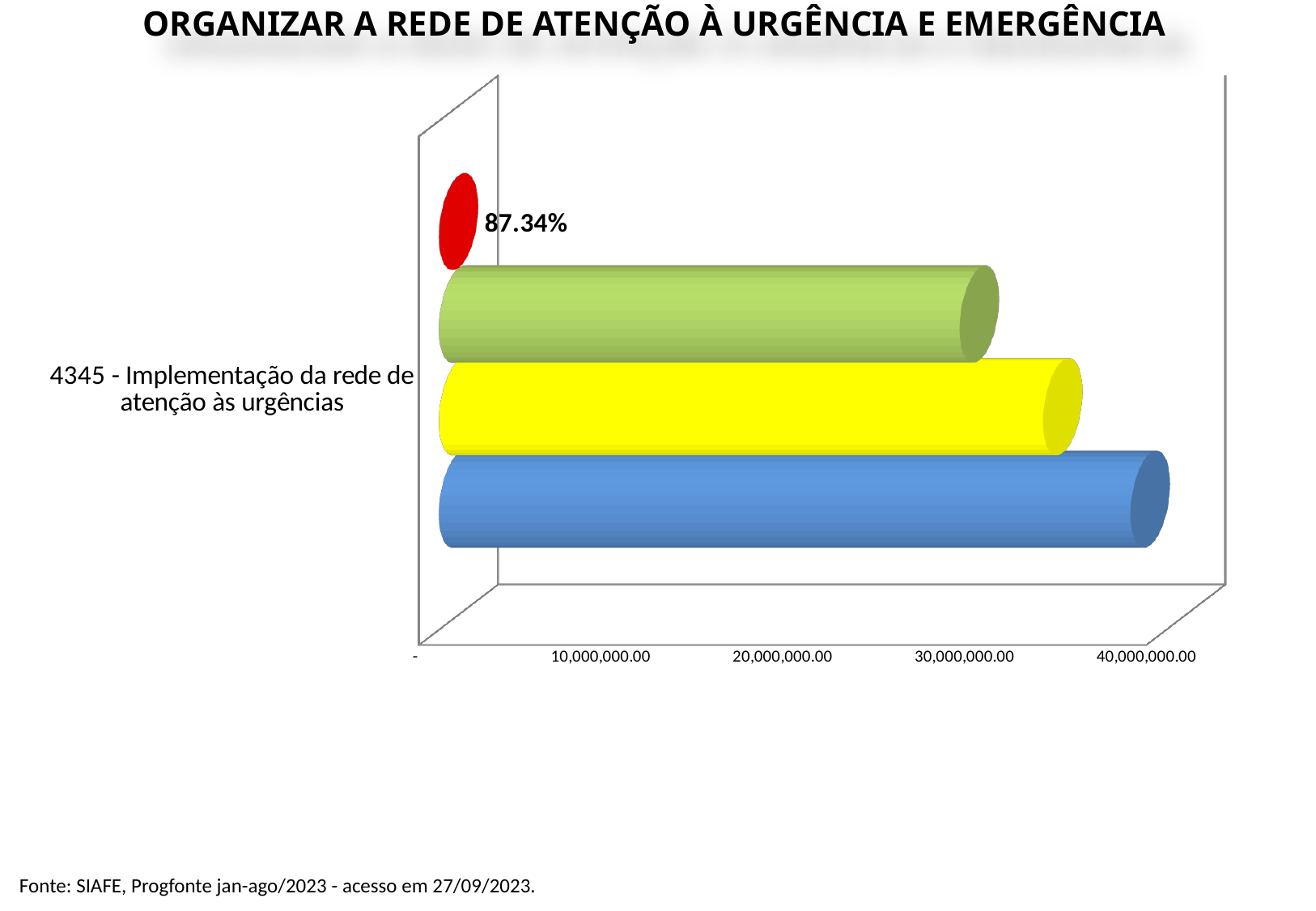
Is the value of the red bar greater or less than 10,000,000.00? less How many categories are shown on the vertical axis of the chart? 1 Is the value of the blue bar greater or less than 30,000,000.00? greater What kind of chart is shown on the slide? bar chart Which coloured bar is the shortest in the chart? red Is the value of the yellow bar greater or less than 20,000,000.00? greater Which coloured bar is the longest in the chart? blue How many bars are plotted for the category '4345 - Implementação da rede de atenção às urgências'? 4 What percentage value is printed as a data label on the chart? 87.34% Which is larger, the blue bar or the green bar? blue What is the title of the slide? ORGANIZAR A REDE DE ATENÇÃO À URGÊNCIA E EMERGÊNCIA What colour is the bar that carries the 87.34% data label? red